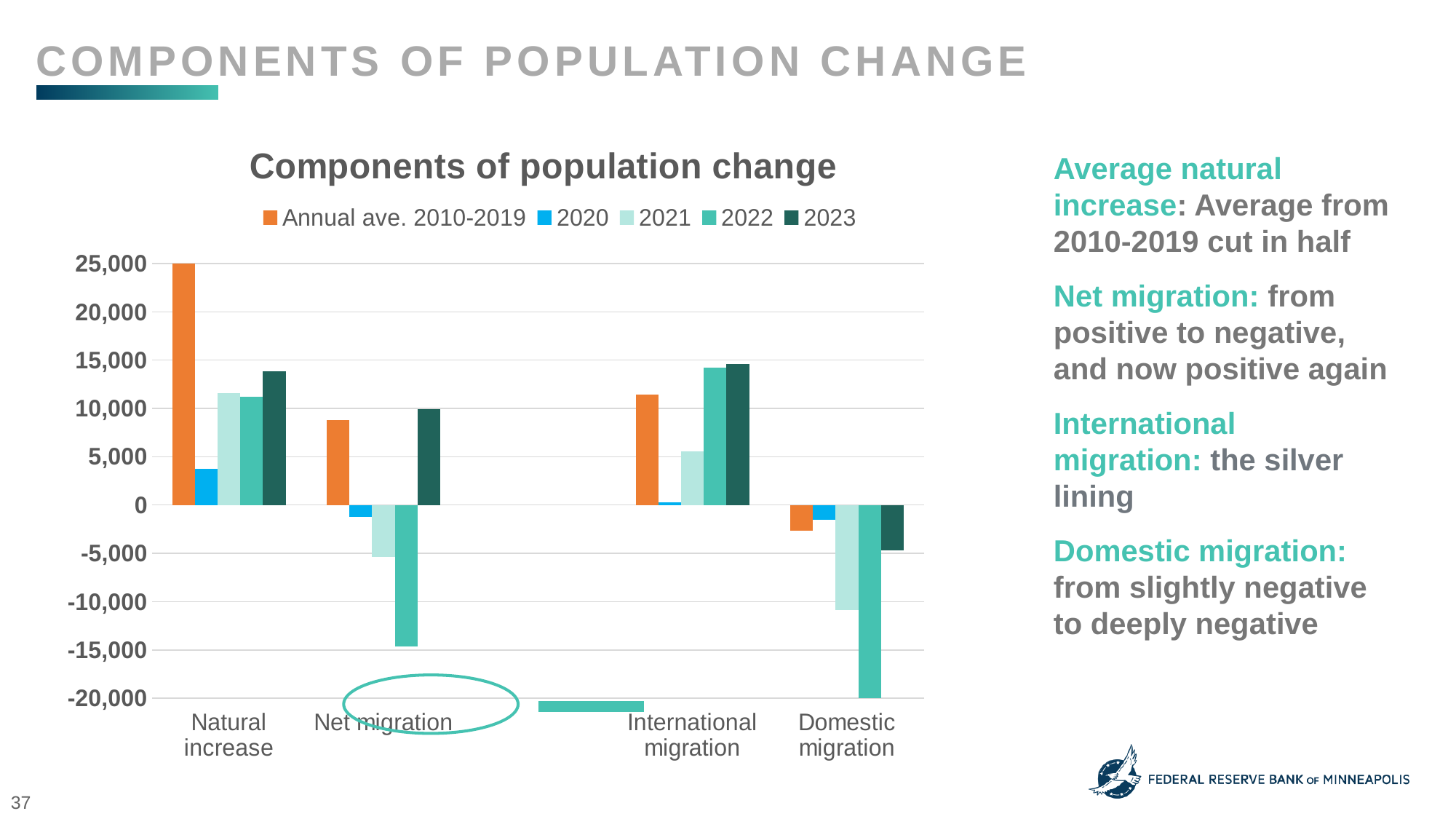
Is the 2023 value for Net migration greater or less than 5,000? greater For Natural increase, which is larger: the 2020 value or the 2023 value? 2023 For International migration, which is larger: the 2021 value or the 2022 value? 2022 Is the Annual ave. 2010-2019 value for Natural increase greater or less than 20,000? greater Which series has the lowest value for Domestic migration? 2022 Which series has the highest value for Natural increase? Annual ave. 2010-2019 What kind of chart is shown on the slide? bar chart Which category has the lowest 2022 value? Domestic migration Is the 2020 value for Natural increase greater or less than 5,000? less What is the title of the chart? Components of population change How many series does the legend list? 5